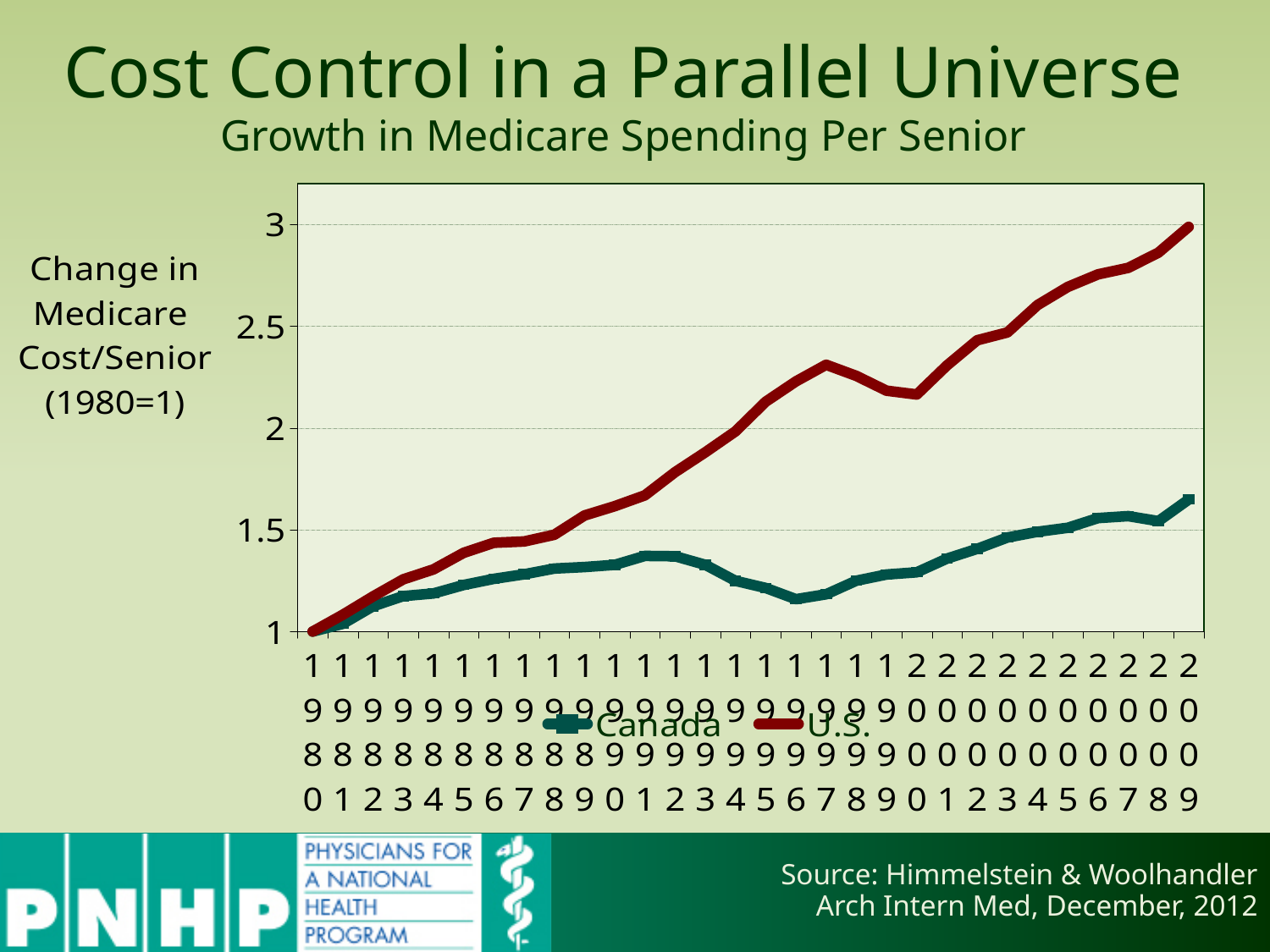
Which series has the higher value in 2009, Canada or the U.S.? U.S. Is the value for the U.S. in 2009 greater or less than 2.5? greater What is the value for the U.S. in 1980? 1 What kind of chart is shown on the slide? line chart How many series does the legend list? 2 Does the U.S. series generally rise or fall from 1980 to 2009? rise Is the value for the U.S. in 1997 greater or less than 2? greater Which two series are shown in the legend? Canada and U.S. Is the value for Canada in 1996 greater or less than 1.5? less How many years are plotted along the x axis? 30 What is the value for Canada in 1980? 1